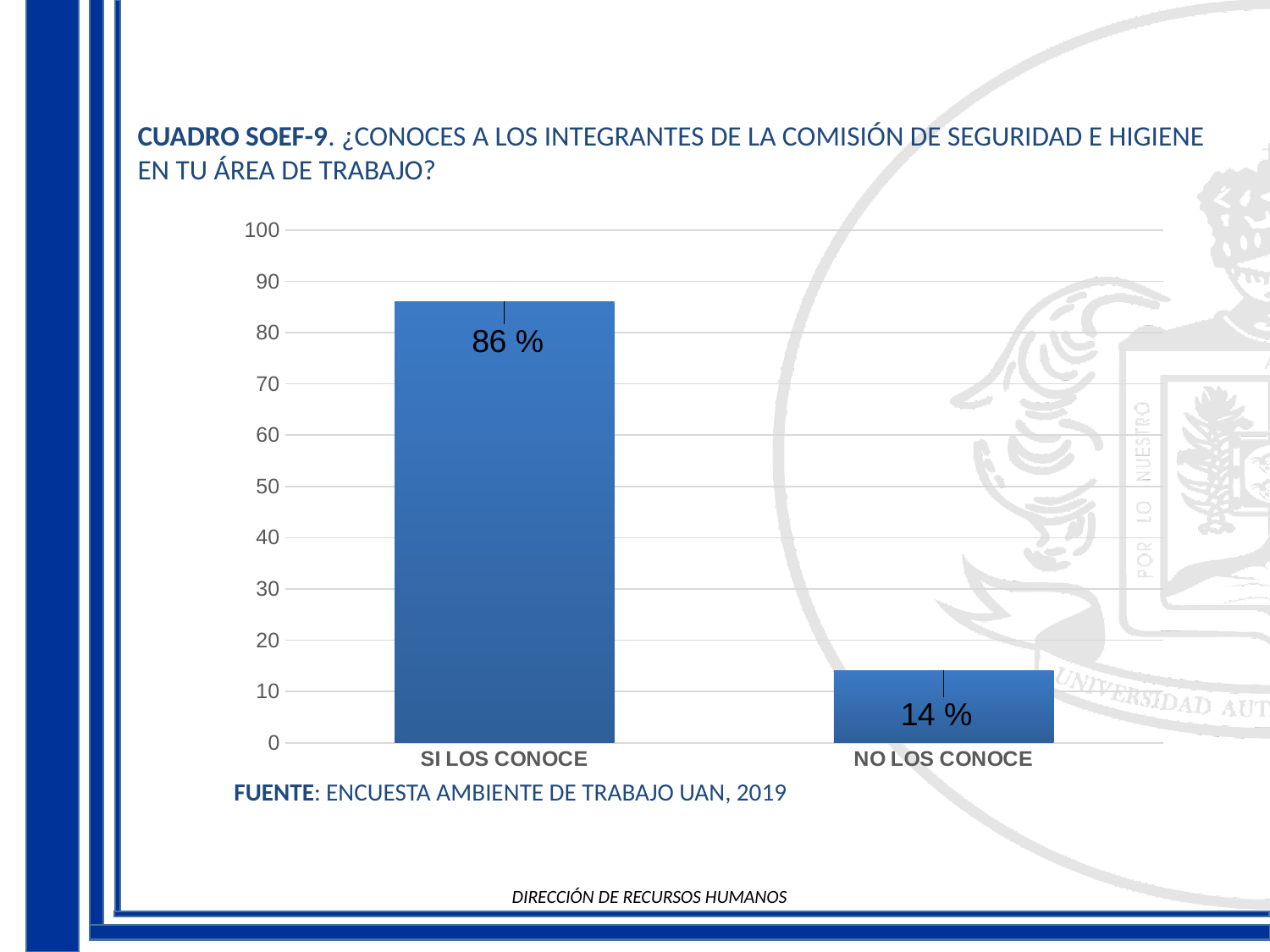
Is the value for NO LOS CONOCE greater or less than 20? less What is the value for SI LOS CONOCE? 86 % What is the maximum value shown on the y axis? 100 Which category has the lowest value? NO LOS CONOCE What kind of chart is shown on the slide? Bar chart How many categories are shown on the x axis? 2 What is the difference between the values for SI LOS CONOCE and NO LOS CONOCE? 72 % Which is larger, the value for SI LOS CONOCE or NO LOS CONOCE? SI LOS CONOCE What is the value for NO LOS CONOCE? 14 % What source is cited below the chart? ENCUESTA AMBIENTE DE TRABAJO UAN, 2019 Which category has the highest value? SI LOS CONOCE Is the value for SI LOS CONOCE greater or less than 80? greater